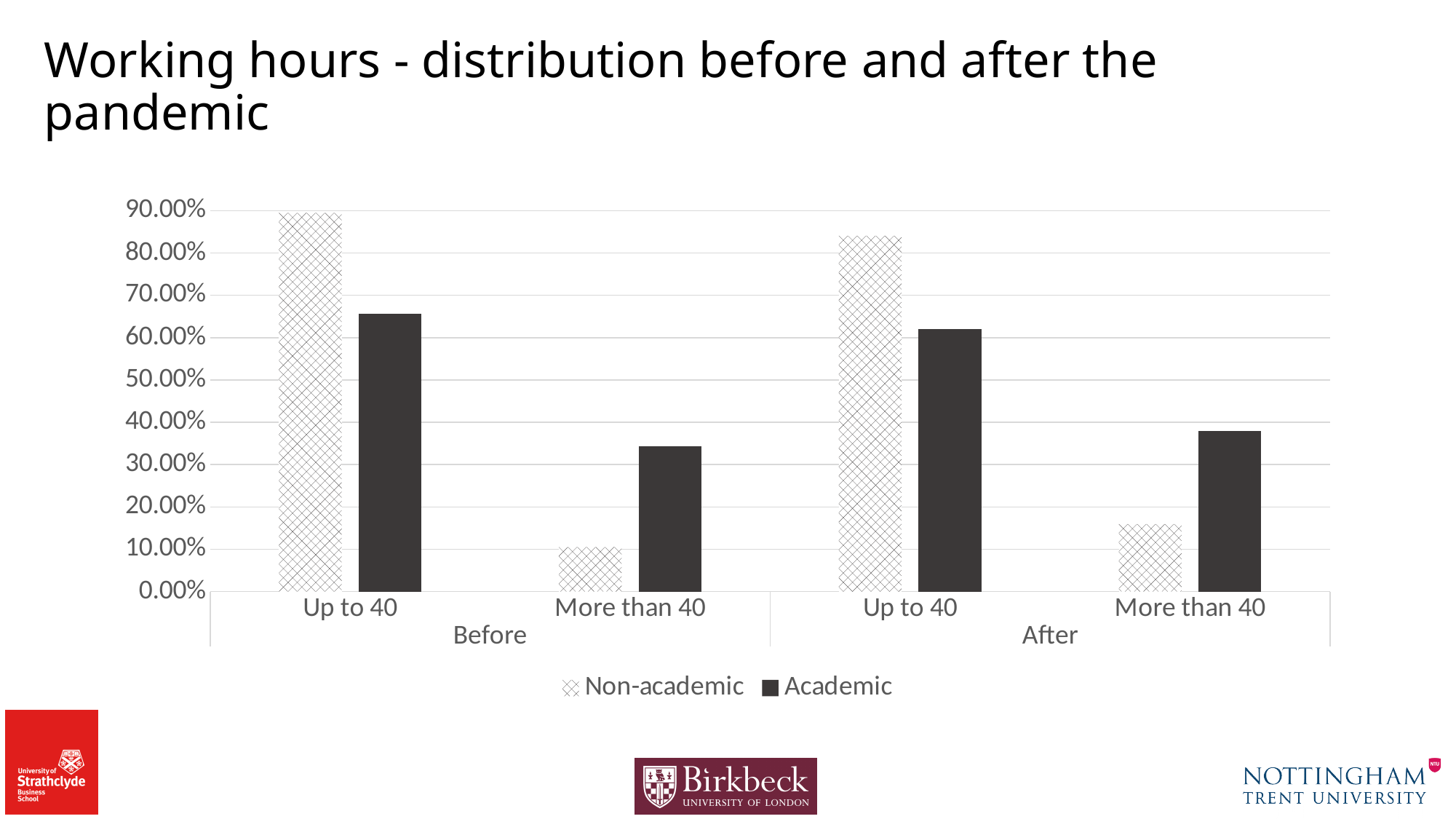
Is the Academic value for 'Up to 40' in the After group greater or less than 70.00%? less What kind of chart is shown on the slide? bar chart Is the Non-academic value for 'Up to 40' in the Before group greater or less than 80.00%? greater Is the Non-academic value for 'More than 40' in the After group greater or less than 20.00%? less Which two series are listed in the legend? Non-academic and Academic Which bar is the tallest in the chart? Non-academic, Up to 40, Before Which bar is the shortest in the chart? Non-academic, More than 40, Before For 'More than 40' in the After group, which series has the larger value, Non-academic or Academic? Academic How many series does the legend list? 2 How many bars are plotted in the chart in total? 8 Which group has the higher Non-academic value for 'Up to 40', Before or After? Before